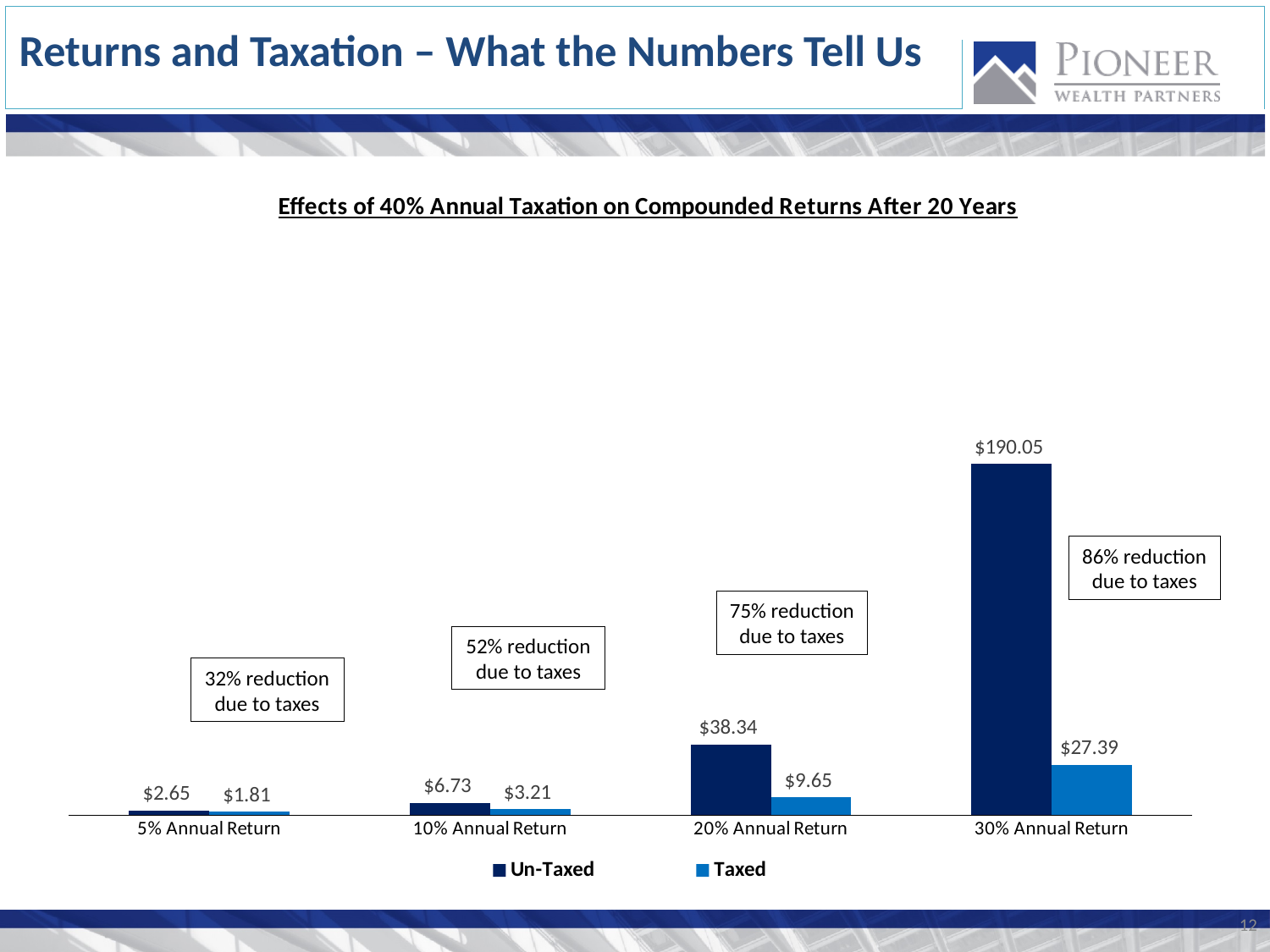
Which is larger: the Un-Taxed value for 20% Annual Return or the Taxed value for 30% Annual Return? Un-Taxed value for 20% Annual Return What percentage reduction due to taxes is shown for 20% Annual Return? 75% Which category has the highest Un-Taxed value? 30% Annual Return Which category has the lowest Taxed value? 5% Annual Return What is the Un-Taxed value for 30% Annual Return? $190.05 How many categories are shown on the x axis? 4 How many series does the legend list? 2 What is the Taxed value for 5% Annual Return? $1.81 What is the Un-Taxed value for 10% Annual Return? $6.73 What is the difference between the Un-Taxed and Taxed values for 30% Annual Return? $162.66 What is the Taxed value for 20% Annual Return? $9.65 What kind of chart is shown on the slide? Bar chart